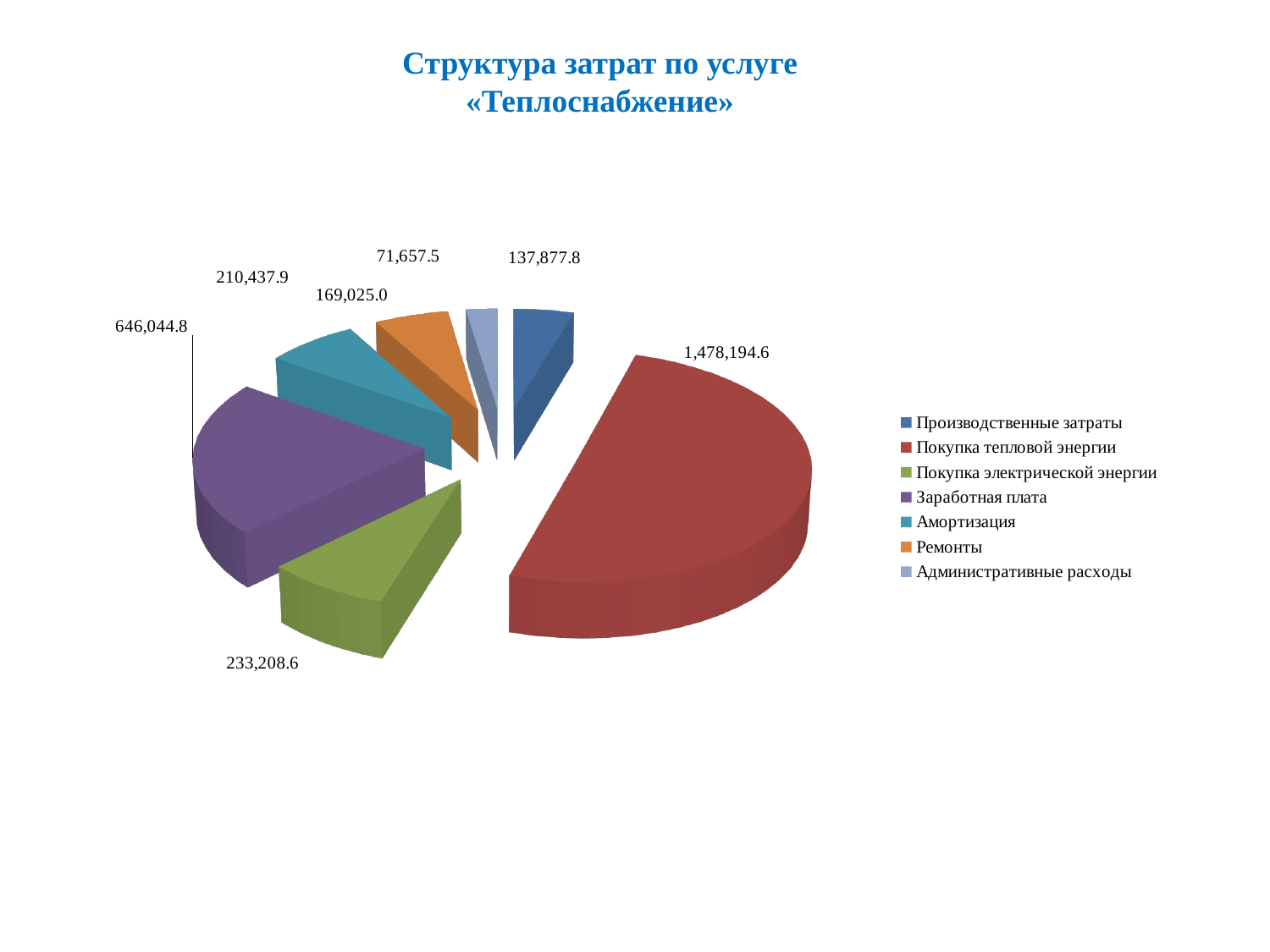
What is the difference between Покупка тепловой энергии and Заработная плата? 832,149.8 What is the value for Ремонты? 169,025.0 How many categories does the pie chart have? 7 What is the value for Заработная плата? 646,044.8 What is the difference between Производственные затраты and Административные расходы? 66,220.3 Which is larger: Покупка электрической энергии or Амортизация? Покупка электрической энергии What is the value for Покупка тепловой энергии? 1,478,194.6 What kind of chart is shown on the slide? Pie chart Which category has the smallest value? Административные расходы What is the title of the chart? Структура затрат по услуге «Теплоснабжение» Which category has the largest value? Покупка тепловой энергии What is the value for Административные расходы? 71,657.5